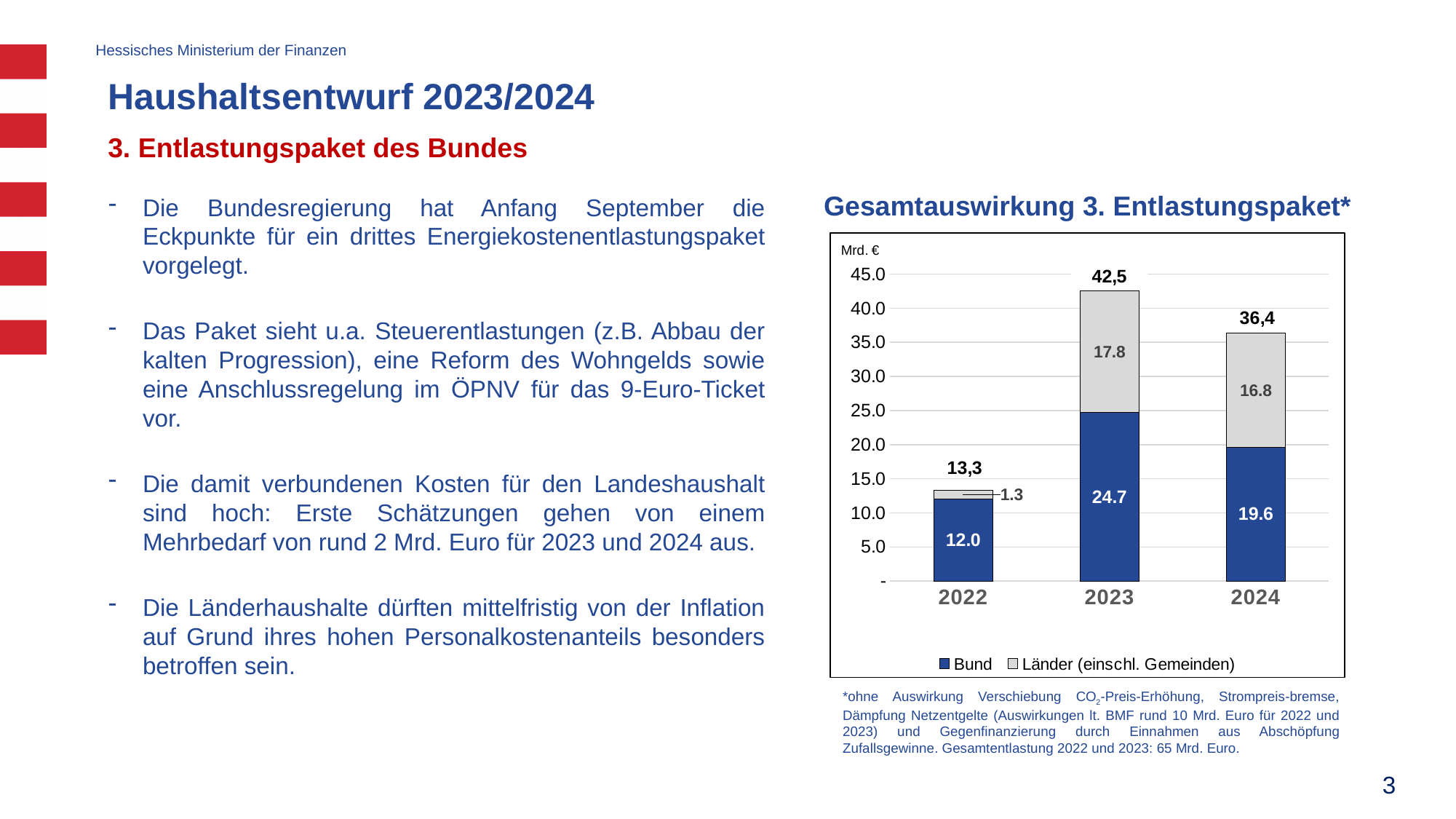
How many years are shown on the x axis? 3 Which year has the highest total? 2023 What is the total of the stacked bar for 2022? 13,3 What is the value for Länder (einschl. Gemeinden) in 2024? 16.8 What is the difference between the Bund values for 2023 and 2024? 5.1 Is the Bund value for 2024 larger than the Länder (einschl. Gemeinden) value for 2024? Yes What is the value for Bund in 2022? 12.0 What kind of chart is shown? Stacked bar chart Which year has the lowest value for Länder (einschl. Gemeinden)? 2022 What is the value for Bund in 2023? 24.7 What is the total of the stacked bar for 2023? 42,5 How many series does the legend list? 2